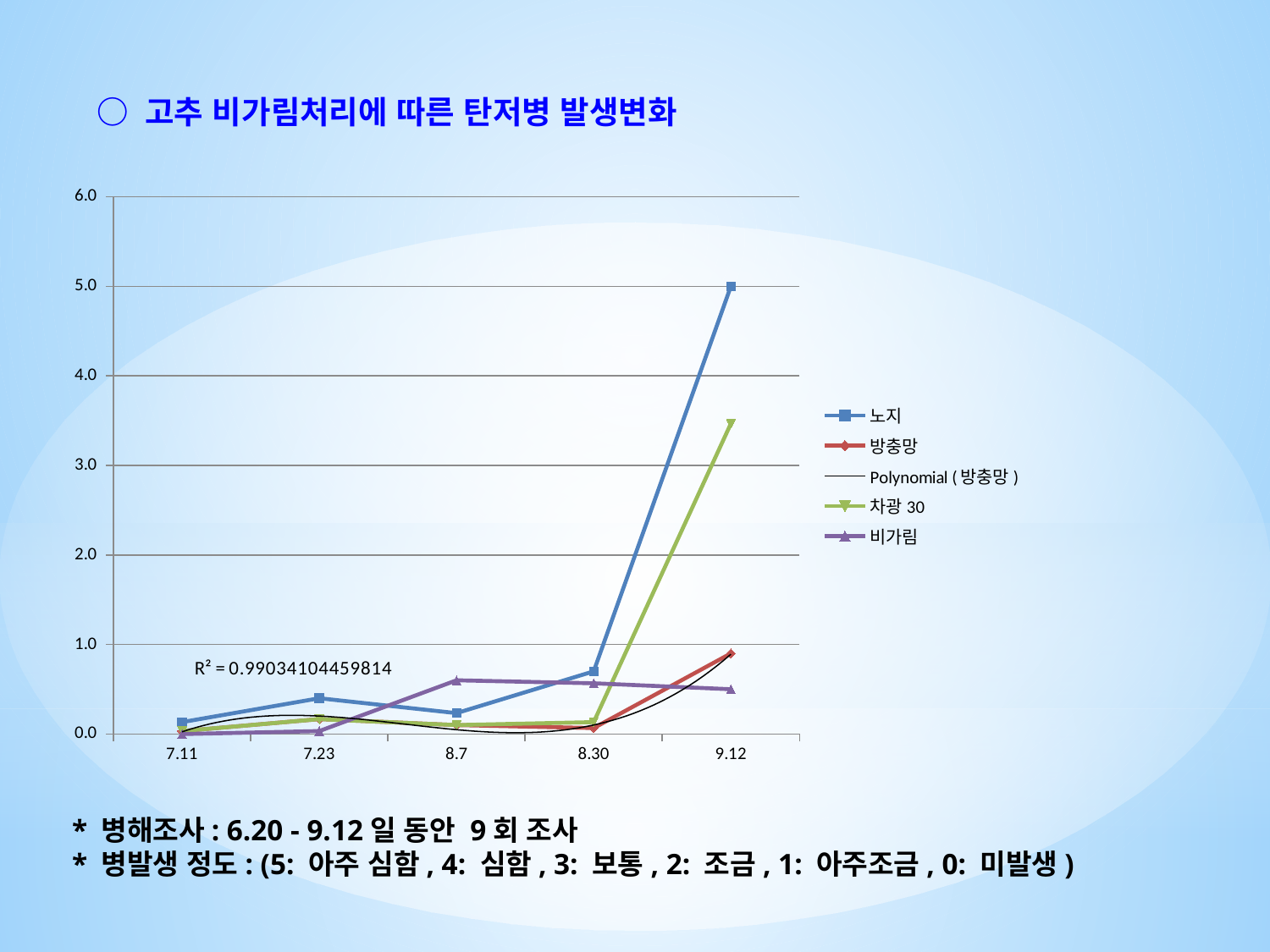
What R² value is printed on the chart? R² = 0.99034104459814 What kind of chart is shown on the slide? line chart Is the value for 노지 at 9.12 greater or less than 4.0? greater At 8.7, which is larger: the value for 비가림 or the value for 노지? 비가림 Is the value for 방충망 at 9.12 greater or less than 1.0? less How many entries does the chart legend list? 5 How many dates are shown on the x axis of the chart? 5 Which series has the highest value at 9.12? 노지 Does the 노지 series rise or fall between 8.30 and 9.12? rise Is the value for 차광 30 at 9.12 greater or less than 3.0? greater At 9.12, which is larger: the value for 노지 or the value for 차광 30? 노지 Which series has the lowest value at 9.12? 비가림